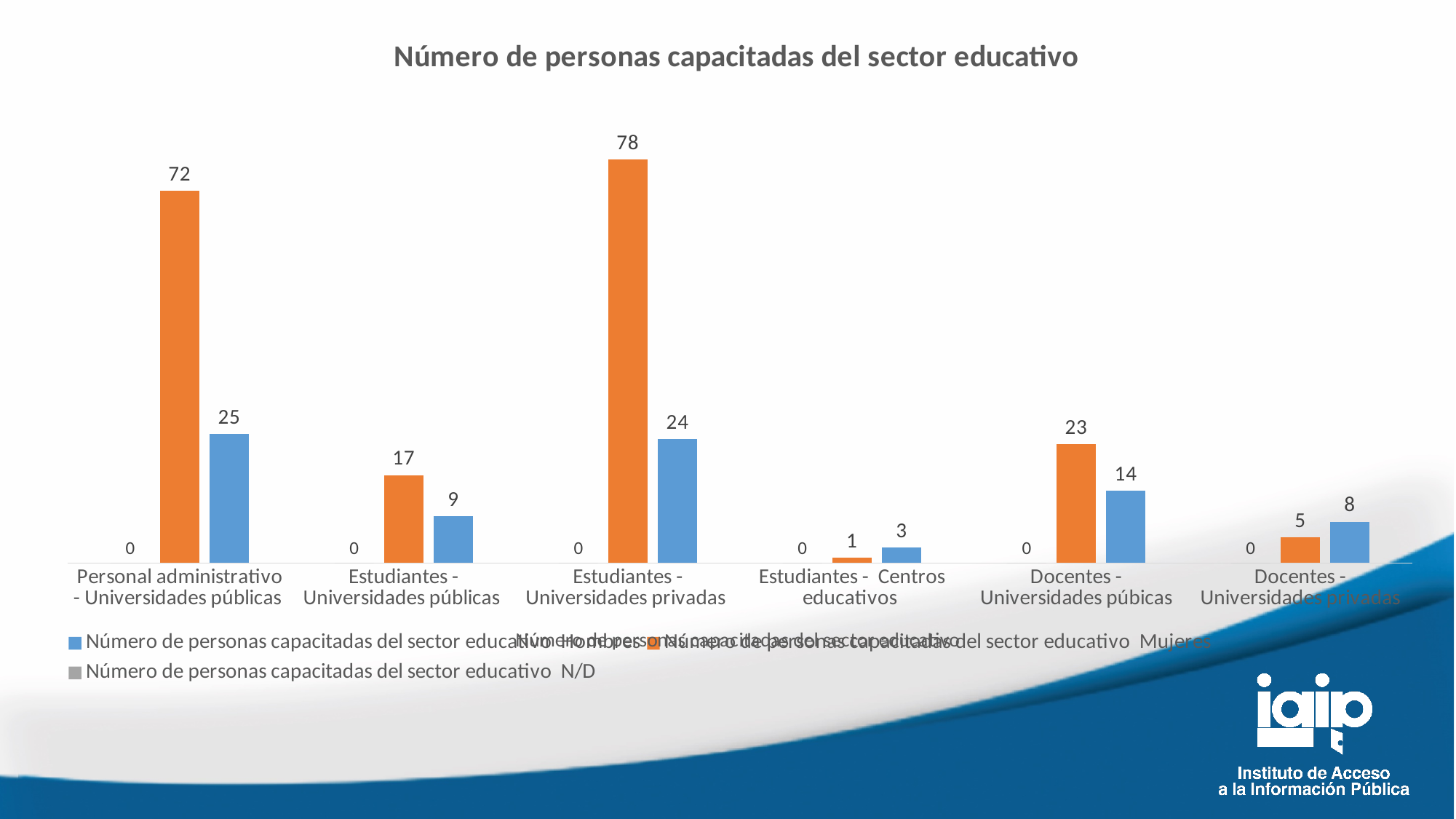
Which category has the highest Mujeres (orange) value? Estudiantes - Universidades privadas What is the Mujeres (orange) value for Docentes - Universidades púbicas? 23 How many series does the chart's legend list? 3 How many categories are shown on the x axis of the chart? 6 For Docentes - Universidades privadas, which is larger: the orange bar or the blue bar? the blue bar What is the value of the blue bar for Personal administrativo - Universidades públicas? 25 What type of chart is shown on the slide? bar chart What is the difference between the Mujeres (orange) value and the blue bar value for Personal administrativo - Universidades públicas? 47 What is the Mujeres (orange) value for Estudiantes - Universidades privadas? 78 What is the title of the chart? Número de personas capacitadas del sector educativo Which category has the lowest Mujeres (orange) value? Estudiantes - Centros educativos What is the N/D (gray) value for Estudiantes - Universidades públicas? 0